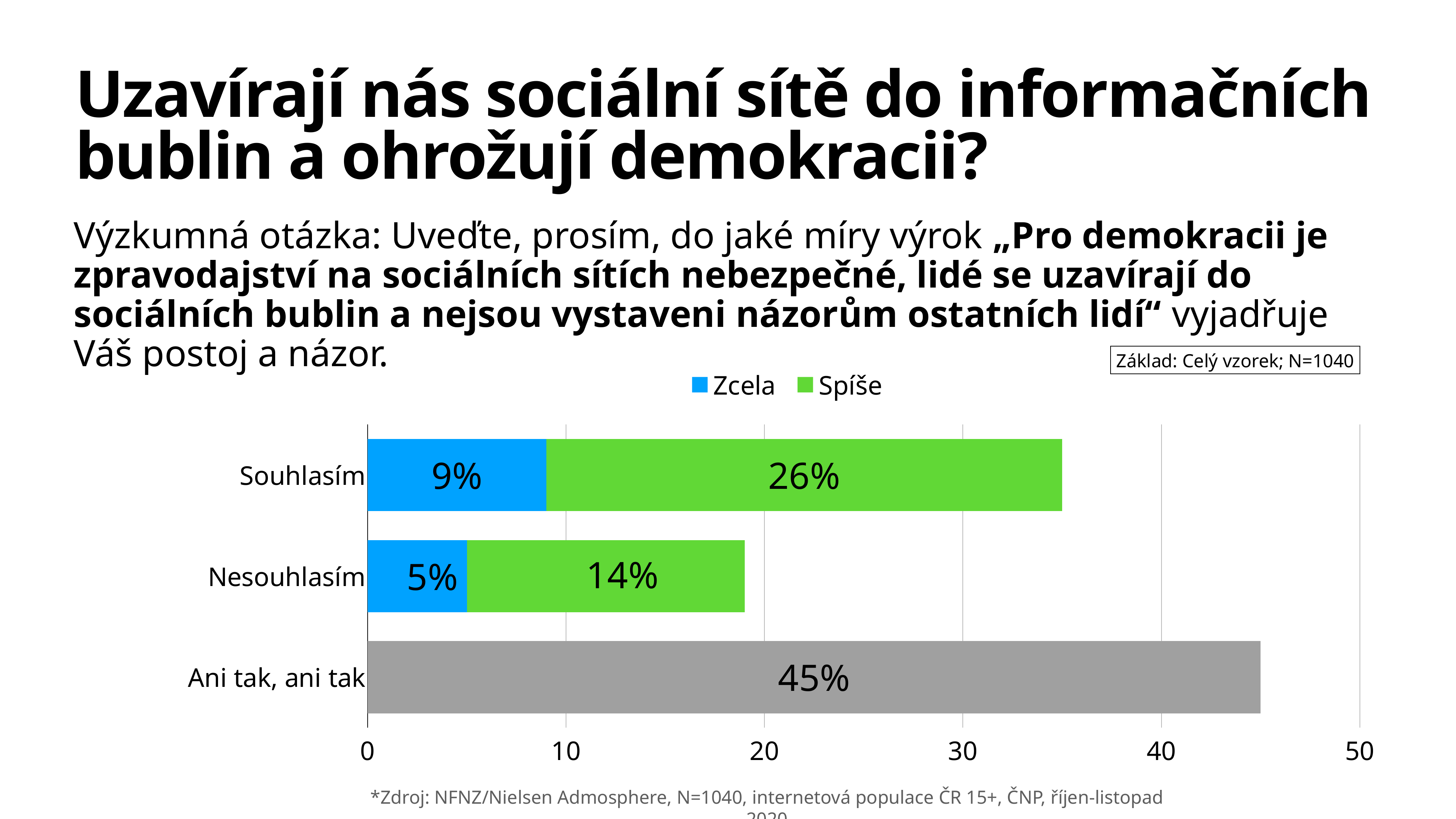
What is the total of the stacked bar for Nesouhlasím? 19% What is the total of the stacked bar for Souhlasím? 35% What kind of chart is shown on the slide? Bar chart What value is shown for Ani tak, ani tak? 45% What is the difference between the 'Spíše' values for Souhlasím and Nesouhlasím? 12% What is the 'Spíše' value for Nesouhlasím? 14% What is the 'Spíše' value for Souhlasím? 26% What is the 'Zcela' value for Souhlasím? 9% How many series does the legend list? 2 How many categories are shown on the y axis? 3 What is the 'Zcela' value for Nesouhlasím? 5% Which is larger: the 'Zcela' value for Souhlasím or for Nesouhlasím? Souhlasím